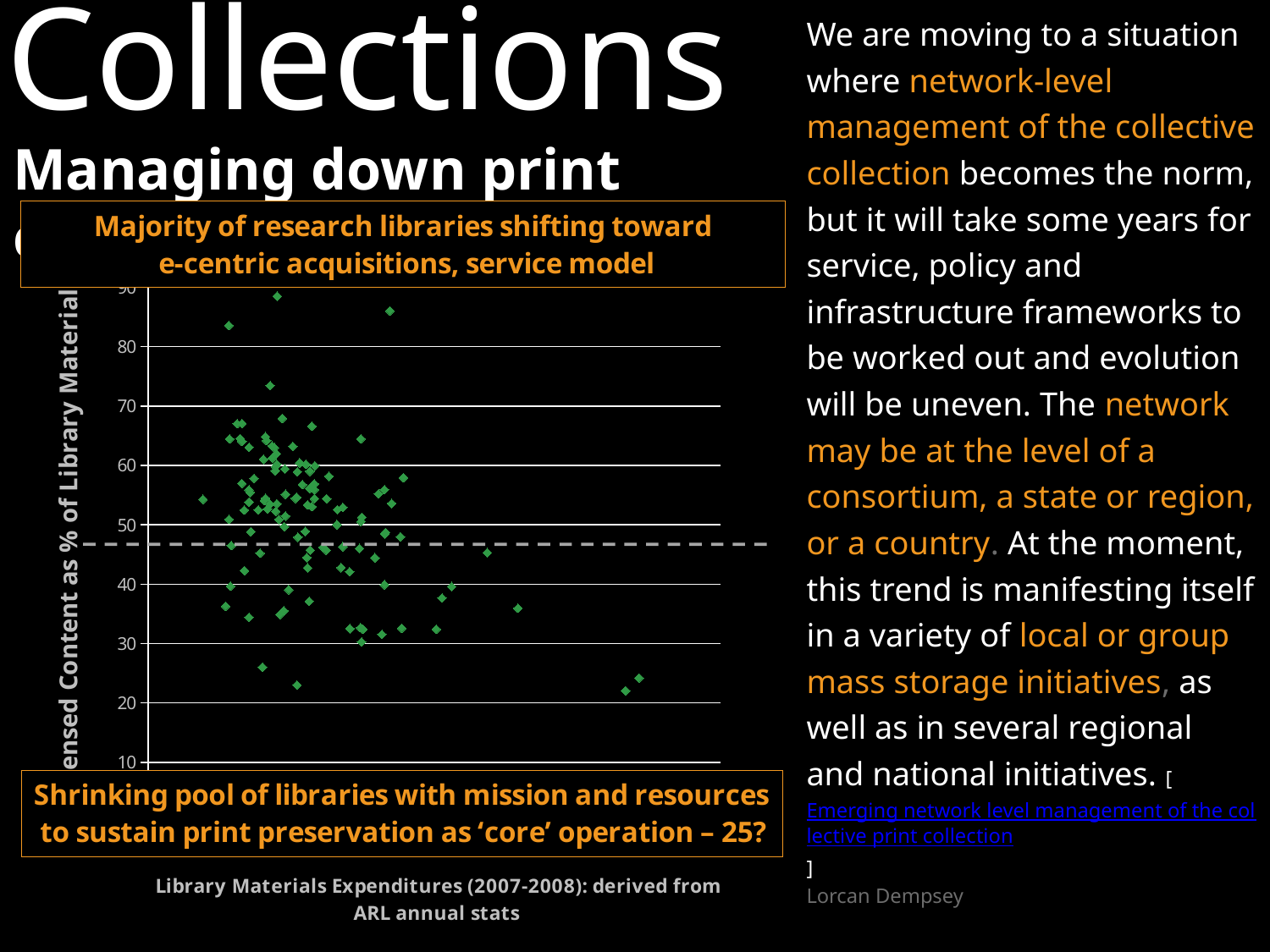
Is the highest plotted point in the scatter chart greater or less than 80? greater Is the lowest plotted point in the scatter chart greater or less than 30? less What kind of chart is shown on the slide? scatter chart Is the dashed horizontal reference line in the chart greater or less than 40? greater What is the highest tick value shown on the chart's vertical axis? 90 What colour are the data markers in the scatter chart? green What is the lowest tick value shown on the chart's vertical axis? 10 What is the title printed beneath the chart? Library Materials Expenditures (2007-2008): derived from ARL annual stats